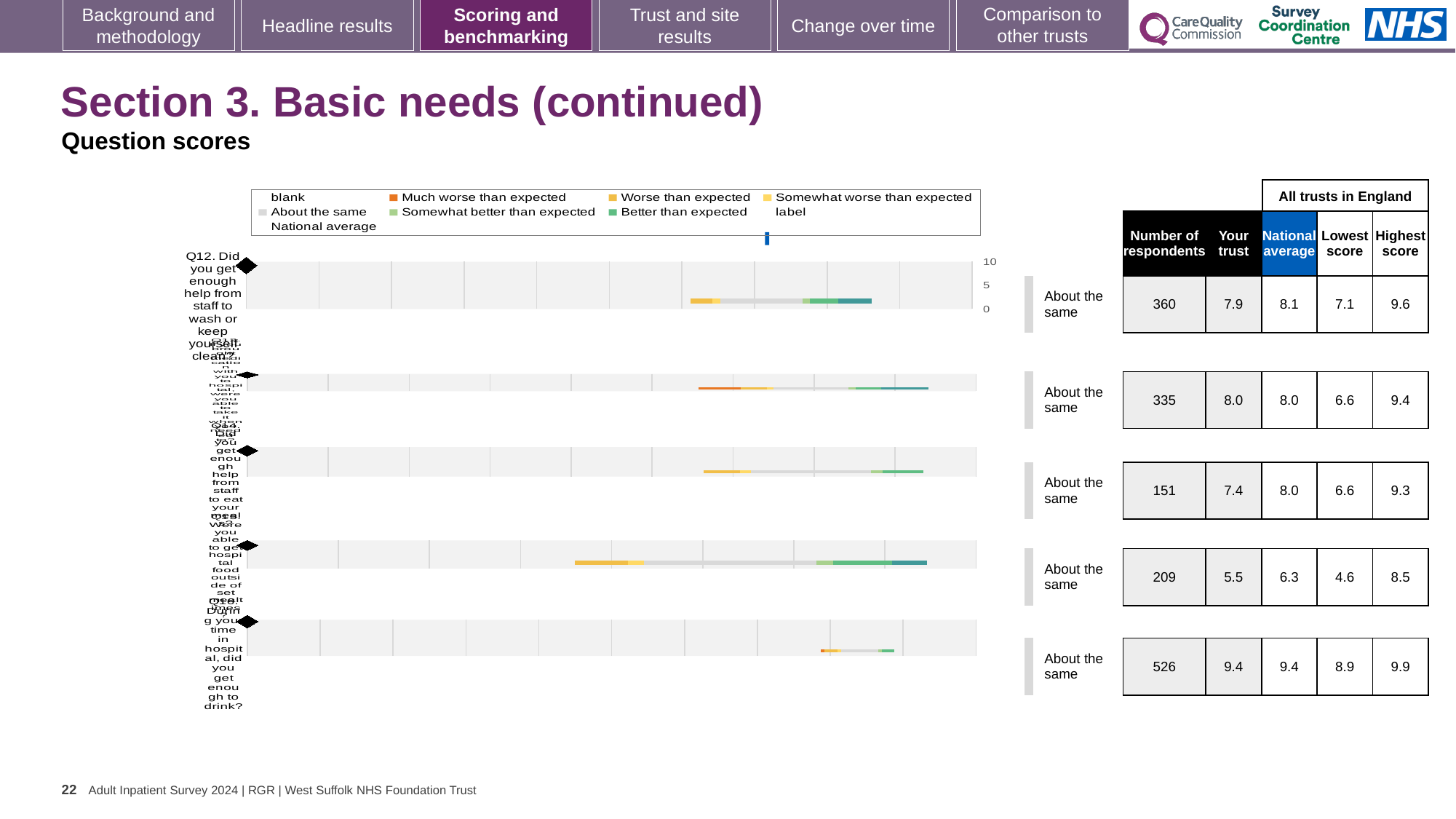
What is the national average for Q14 (enough help from staff to eat your meals)? 8.0 Which question row has the highest 'Your trust' score? Q16 (did you get enough to drink) What is the 'Your trust' score for Q12 (help from staff to wash or keep yourself clean)? 7.9 Which question row has the lowest 'Your trust' score? Q15 (hospital food outside of set meal times) What is the lowest score across all trusts in England for Q16 (did you get enough to drink)? 8.9 What benchmark category is shown for every question row on the slide? About the same Is the 'Your trust' score for Q12 larger or smaller than the national average for Q12? smaller What is the highest score across all trusts in England for Q15 (hospital food outside of set meal times)? 8.5 How many question rows (bars) are plotted in the chart? 5 What is the number of respondents for the last row, Q16 (did you get enough to drink)? 526 What is the difference between the national average and the 'Your trust' score for Q15 (hospital food outside of set meal times)? 0.8 What kind of chart is shown on the slide? bar chart